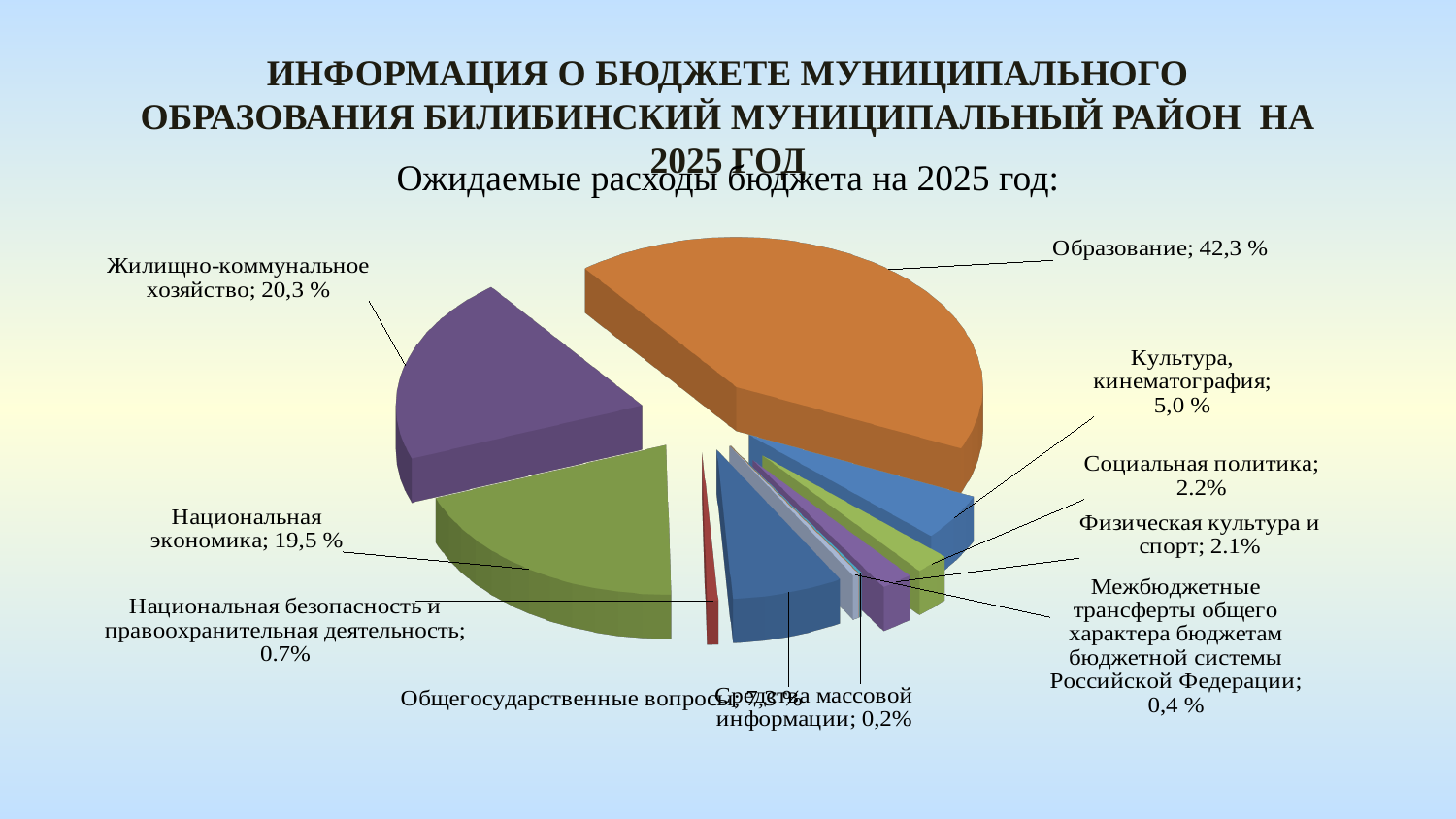
How many categories are shown in the pie chart? 10 What is the title of the chart? Ожидаемые расходы бюджета на 2025 год: What kind of chart is shown on the slide? Pie chart Which category has the largest share of the pie? Образование What share is shown for Культура, кинематография? 5,0 % What share is shown for Жилищно-коммунальное хозяйство? 20,3 % Which has the larger share: Жилищно-коммунальное хозяйство or Национальная экономика? Жилищно-коммунальное хозяйство What is the difference between the shares of Образование and Жилищно-коммунальное хозяйство? 22,0 % What share of expected 2025 budget expenditures goes to Образование? 42,3 % Which category has the smallest share of the pie? Средства массовой информации What share is shown for Национальная экономика? 19,5 % What share is shown for Межбюджетные трансферты общего характера бюджетам бюджетной системы Российской Федерации? 0,4 %